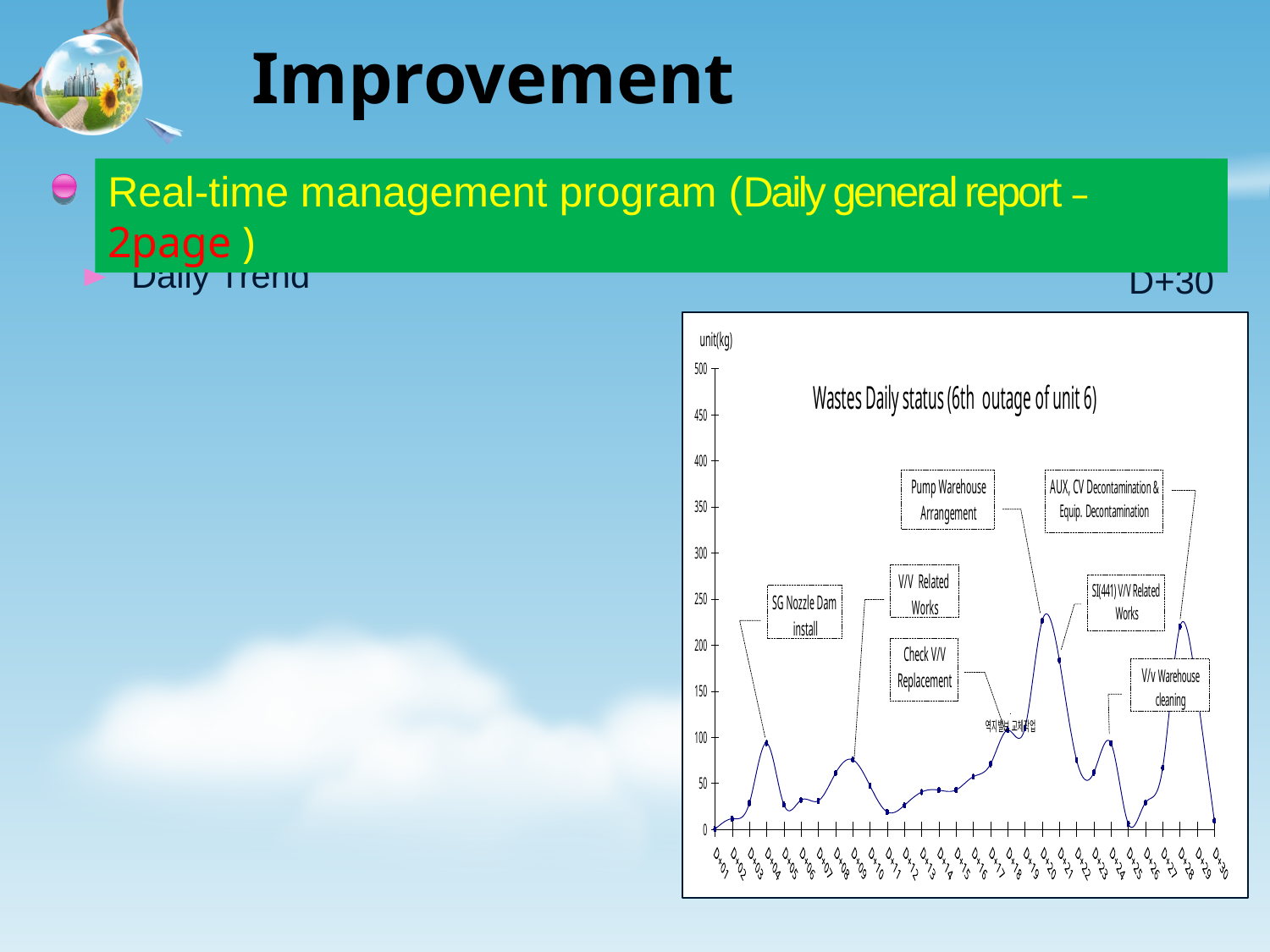
Which has the larger value, D+20 or D+11? D+20 Which has the larger value, D+28 or D+04? D+28 What is the title of the chart? Wastes Daily status (6th outage of unit 6) Is the value for D+09 greater or less than 100? less Is the value for D+21 greater or less than 150? greater Is the value for D+20 greater or less than 200? greater What unit is shown for the y axis of the chart? unit(kg) What kind of chart is shown on the slide? line chart Do the values rise or fall from D+20 to D+25? fall How many daily points (D+01 to D+30) are plotted on the x axis? 30